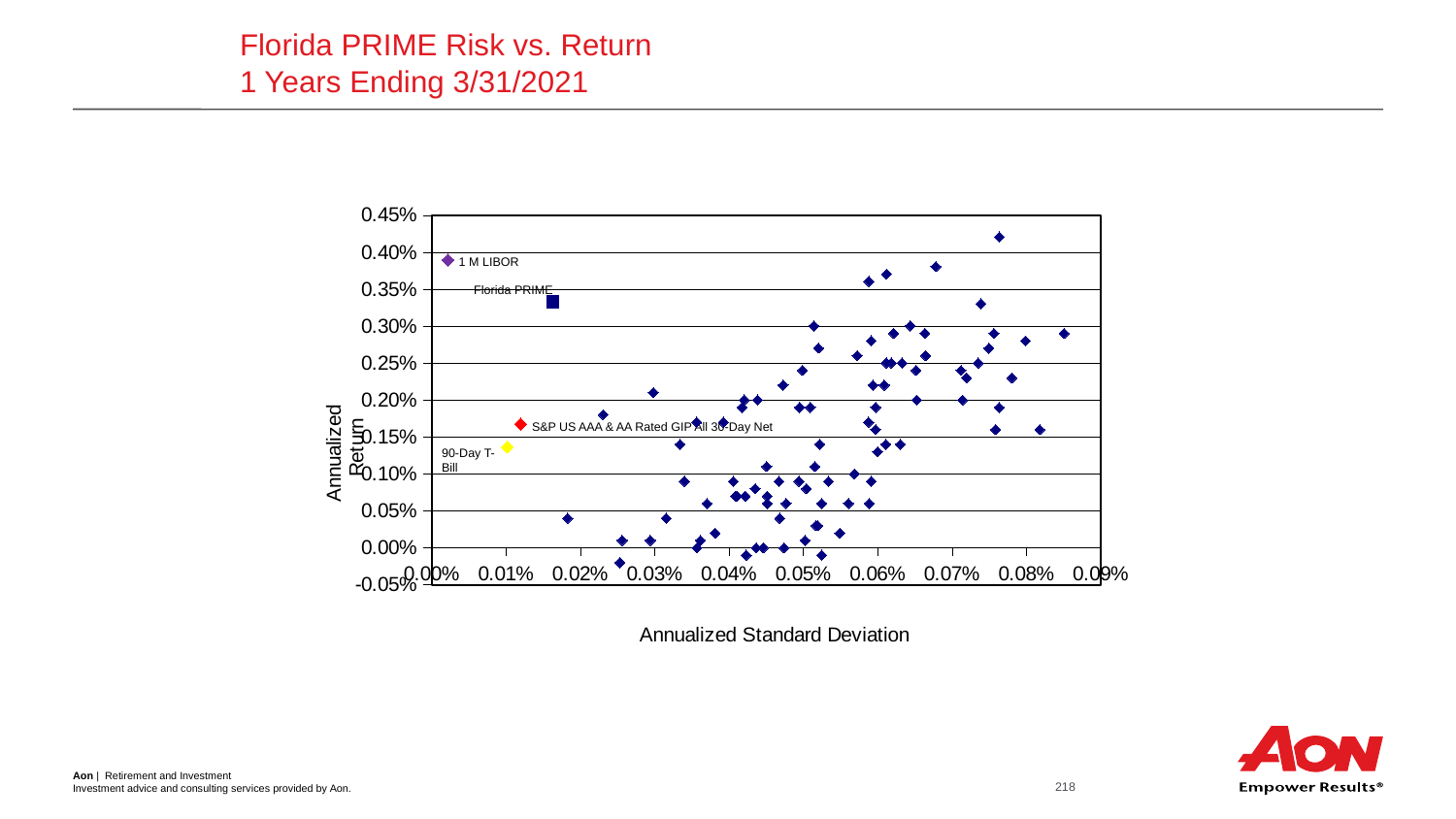
Is the annualized return for Florida PRIME greater or less than 0.30%? greater Is the annualized return for 1 M LIBOR greater or less than 0.35%? greater Which has the higher annualized return, 1 M LIBOR or Florida PRIME? 1 M LIBOR Among the labeled points (1 M LIBOR, Florida PRIME, S&P US AAA & AA Rated GIP All 30-Day Net, 90-Day T-Bill), which has the lowest annualized return? 90-Day T-Bill Which has the higher annualized return, Florida PRIME or the 90-Day T-Bill? Florida PRIME What is the label of the horizontal axis of the chart? Annualized Standard Deviation Is the annualized return for the 90-Day T-Bill greater or less than 0.15%? less What kind of chart is shown on the slide? Scatter chart Among the labeled points (1 M LIBOR, Florida PRIME, S&P US AAA & AA Rated GIP All 30-Day Net, 90-Day T-Bill), which has the highest annualized return? 1 M LIBOR What is the title of the chart on the slide? Florida PRIME Risk vs. Return 1 Years Ending 3/31/2021